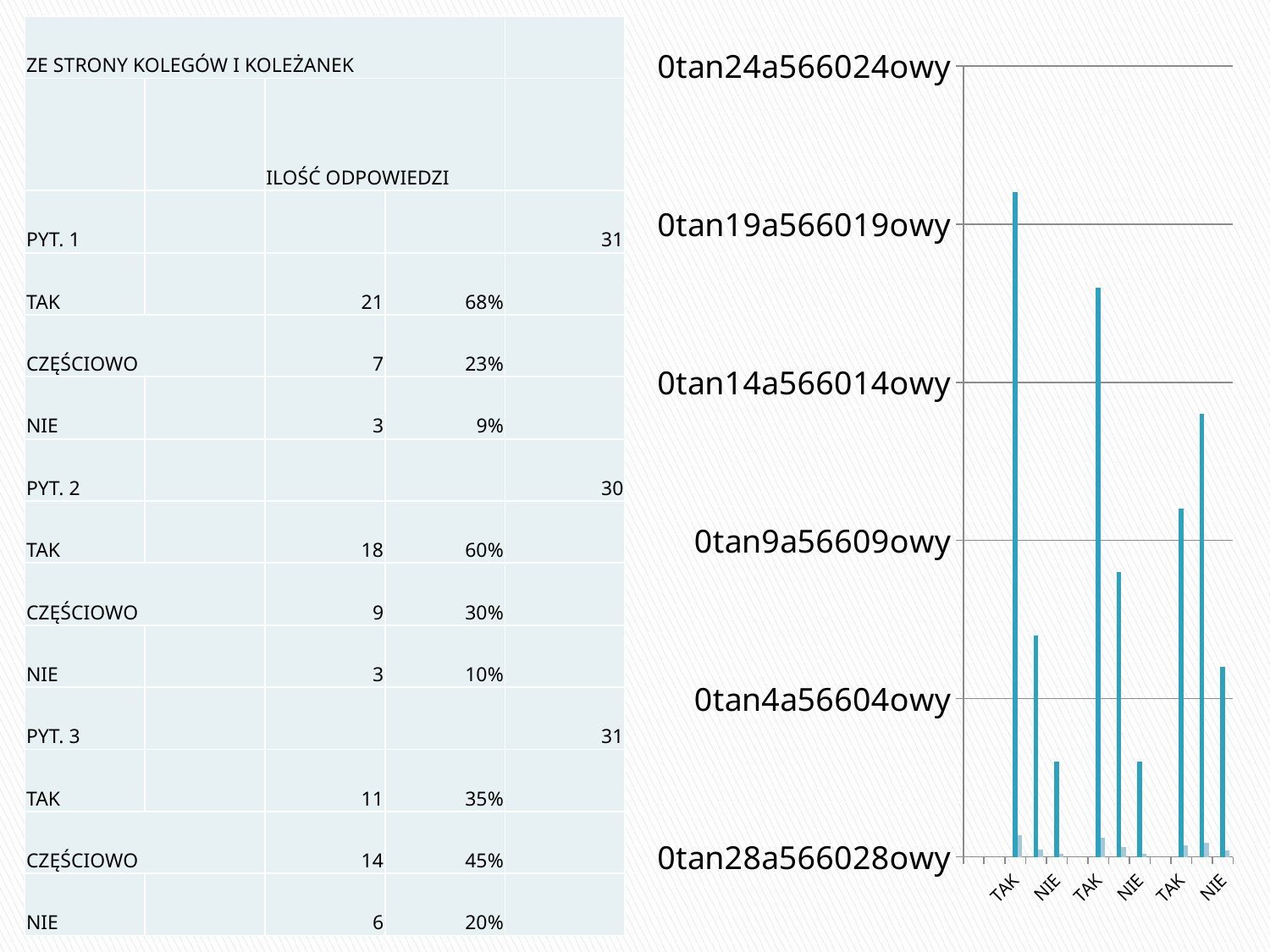
In the chart on the right, is the first TAK bar taller or shorter than the first NIE bar? taller In the chart on the right, is the last NIE bar taller or shorter than the first NIE bar? taller What colour are the tall bars in the chart on the right? blue How many tall bars are plotted in the chart on the right? 9 In the chart on the right, which bar is the tallest? the first TAK bar In the chart on the right, which group of three bars contains the tallest bar: the first, second or third? the first In the chart on the right, is the first TAK bar taller or shorter than the second TAK bar? taller What kind of chart is shown on the right side of the slide? bar chart What category labels are readable on the x axis of the chart on the right? TAK and NIE